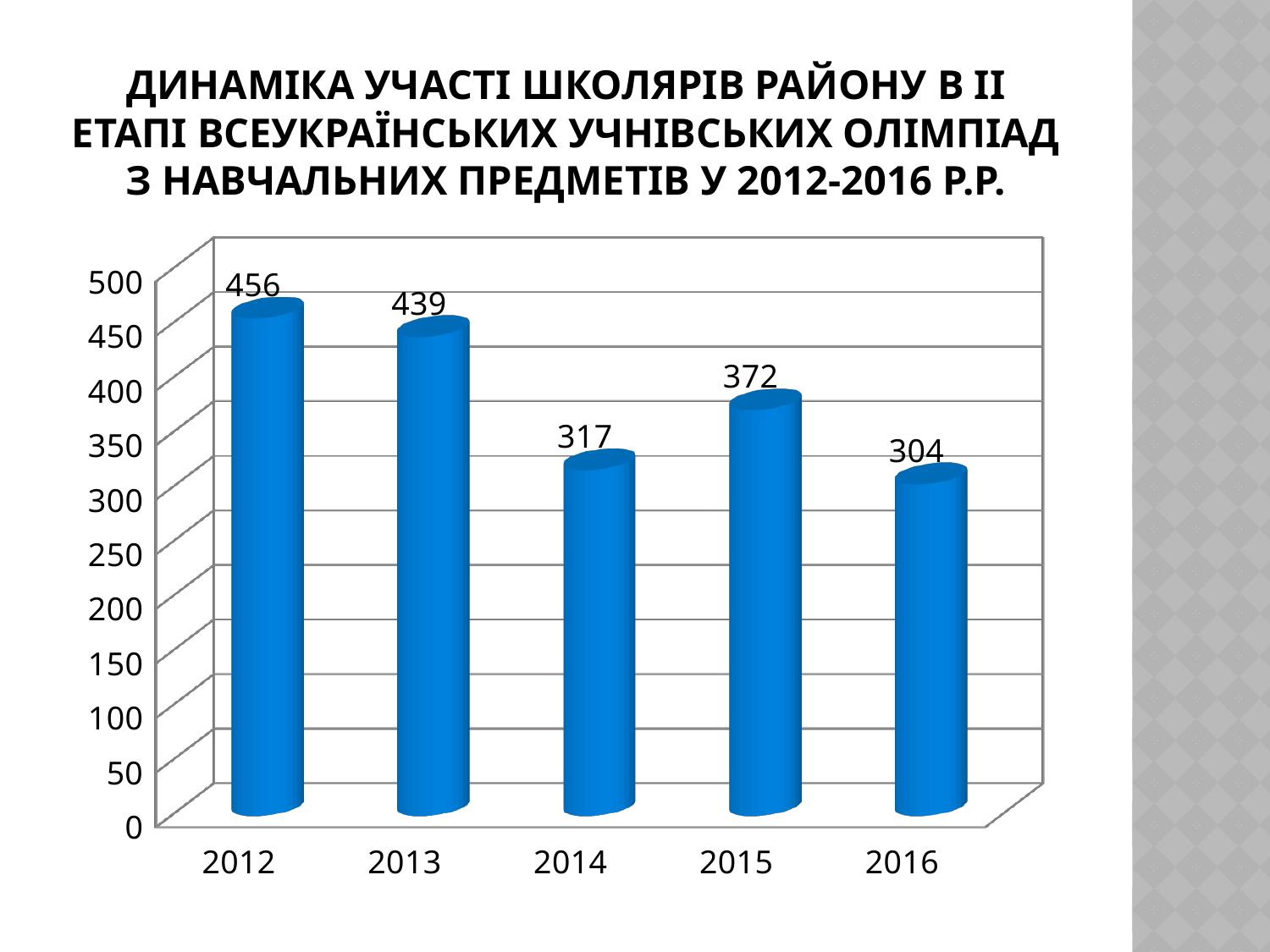
What kind of chart is shown on the slide? bar chart Which year has the highest value? 2012 Is the value for 2015 greater or less than 350? greater What is the value for 2016? 304 Which year has the lowest value? 2016 Which is larger, the value for 2015 or the value for 2014? 2015 What is the value for 2012? 456 How many years are shown on the x axis? 5 What is the value for 2014? 317 What is the difference between the values for 2013 and 2014? 122 Do the values generally rise or fall from 2012 to 2016? fall What is the difference between the values for 2012 and 2016? 152